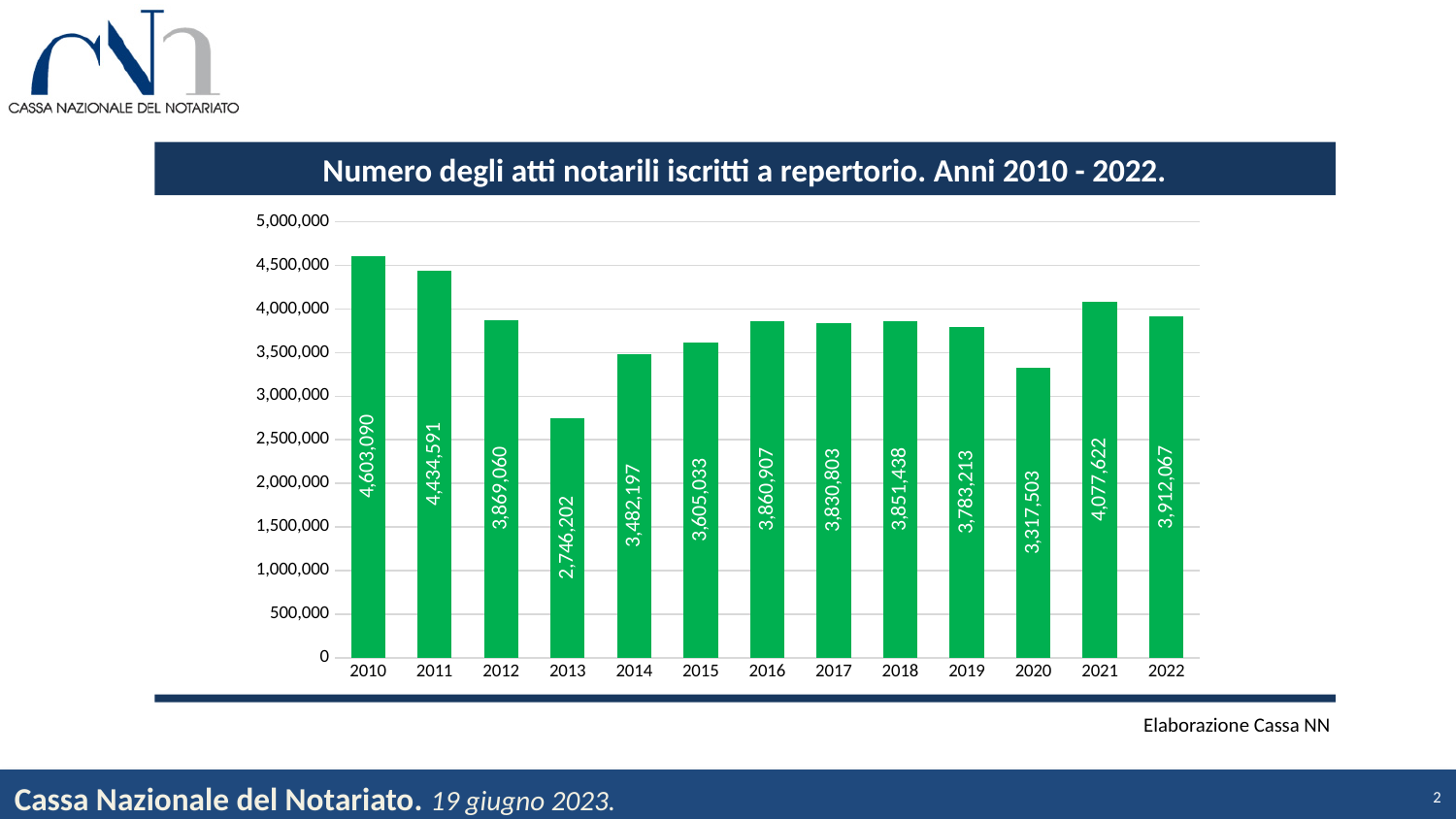
Is the value for 2011 greater or less than 4,000,000? greater What is the value for 2020? 3,317,503 What is the value for 2013? 2,746,202 Which is larger, the value for 2021 or the value for 2022? 2021 What is the title of the chart? Numero degli atti notarili iscritti a repertorio. Anni 2010 - 2022. What is the difference between the values for 2010 and 2013? 1,856,888 What kind of chart is shown on the slide? bar chart What is the value for 2022? 3,912,067 Which year has the highest value? 2010 What is the difference between the values for 2021 and 2020? 760,119 Which year has the lowest value? 2013 How many years are shown on the x axis? 13